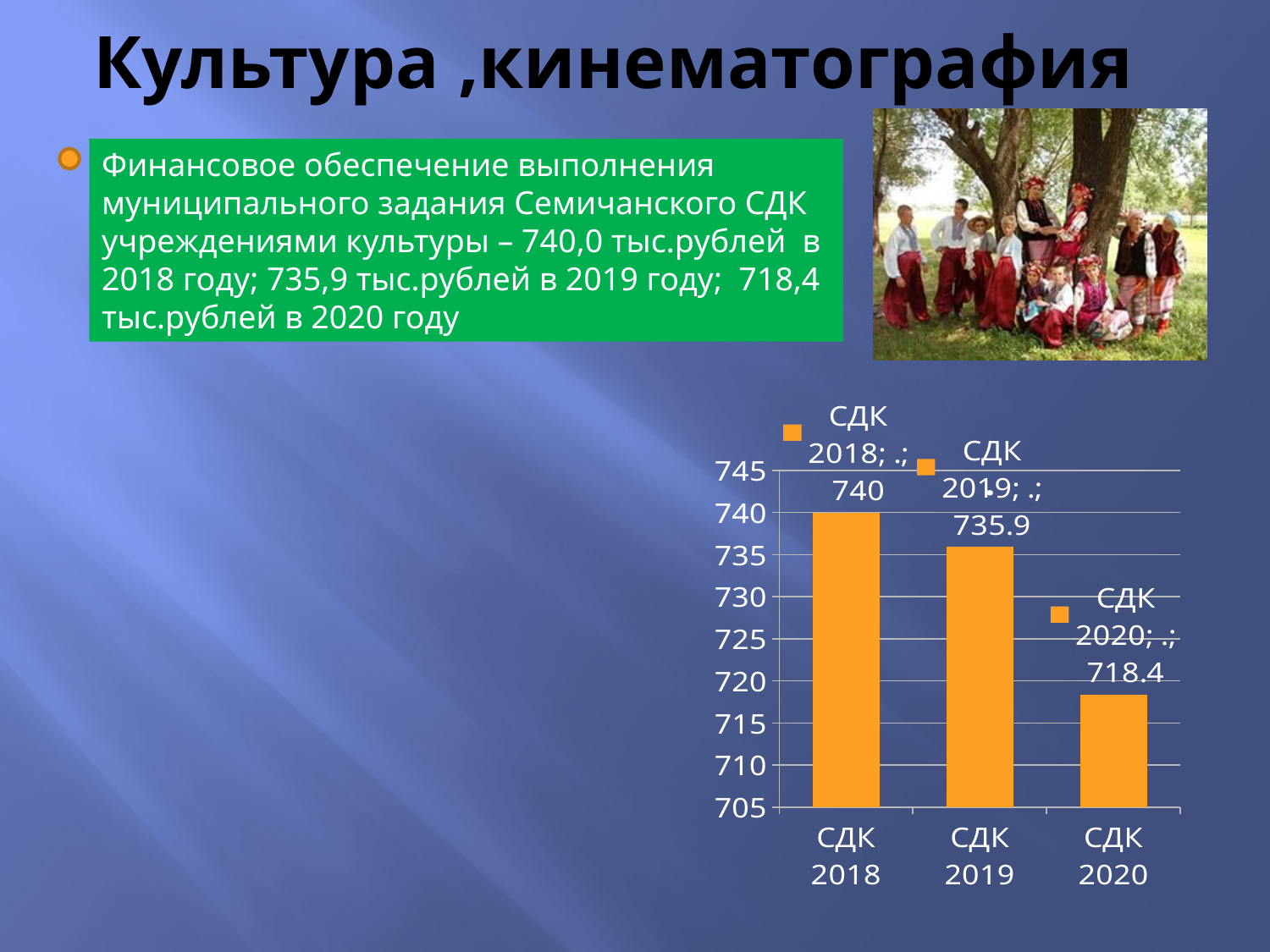
What is the value for СДК 2018 in the chart? 740 How many bars are shown in the chart? 3 Which is larger, the value for СДК 2019 or the value for СДК 2020? СДК 2019 Which category has the lowest value in the chart? СДК 2020 What is the difference between the values for СДК 2019 and СДК 2020? 17.5 What is the value for СДК 2019 in the chart? 735.9 What kind of chart is shown on the slide? bar chart Do the values rise or fall from СДК 2018 to СДК 2020? fall What is the difference between the values for СДК 2018 and СДК 2020? 21.6 What is the value for СДК 2020 in the chart? 718.4 Is the value for СДК 2020 greater or less than 720? less Which category has the highest value in the chart? СДК 2018